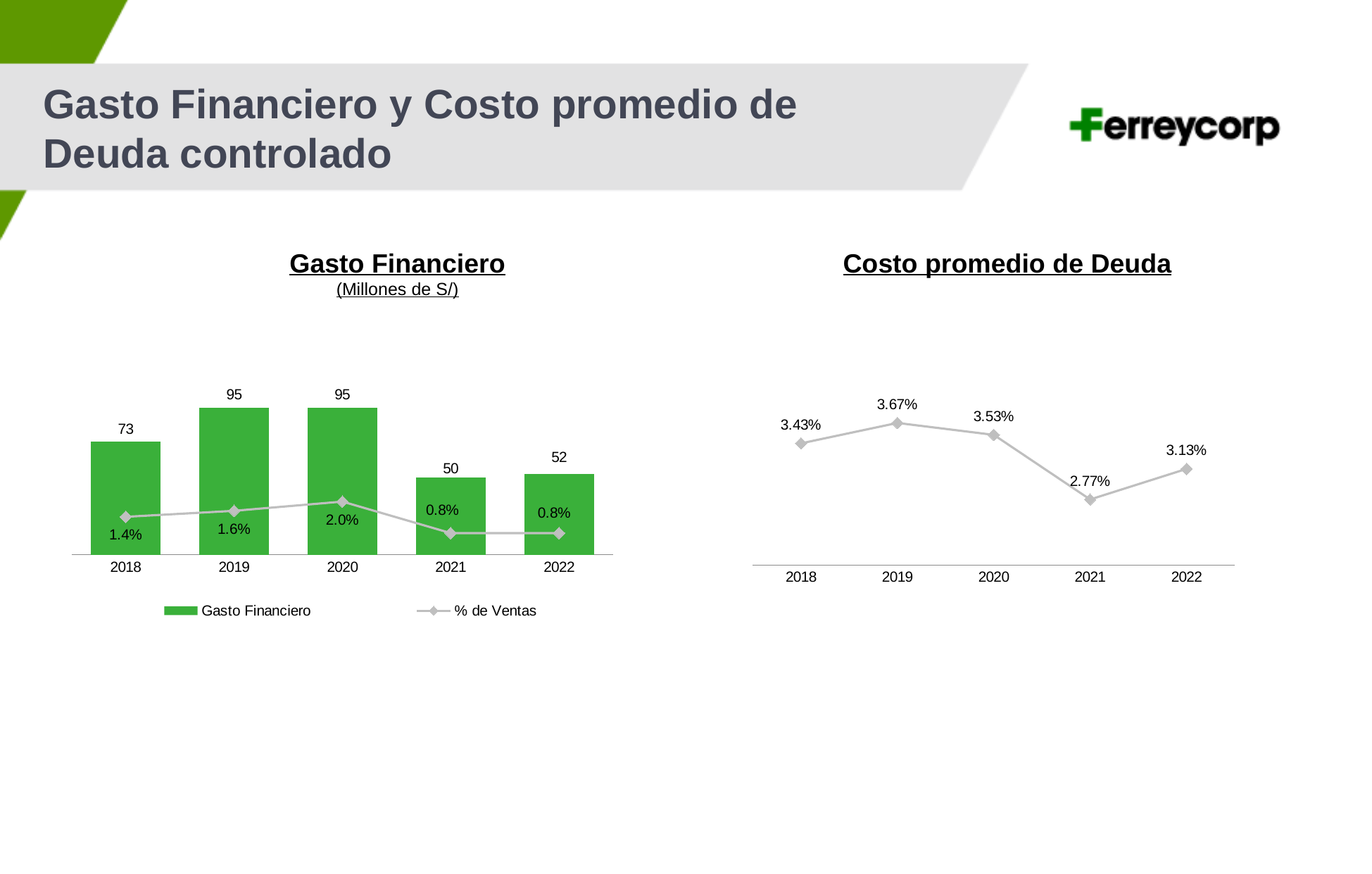
In the Costo promedio de Deuda chart, what is the value for 2021? 2.77% In the Costo promedio de Deuda chart, which year has the highest value? 2019 In the Gasto Financiero chart, which year has the lowest Gasto Financiero bar? 2021 In the Gasto Financiero chart, what is the % de Ventas value for 2020? 2.0% In the Gasto Financiero chart, how many years are shown on the x axis? 5 In the Costo promedio de Deuda chart, does the value rise or fall from 2021 to 2022? rise In the Gasto Financiero chart, what is the Gasto Financiero value for 2019? 95 In the Gasto Financiero chart, how many series does the legend list? 2 What kind of chart is the Costo promedio de Deuda chart? Line chart In the Gasto Financiero chart, is the Gasto Financiero value for 2018 larger or smaller than the value for 2022? larger In the Costo promedio de Deuda chart, what is the difference between the 2019 and 2021 values? 0.90% In the Gasto Financiero chart, what is the difference between the Gasto Financiero values for 2018 and 2021? 23